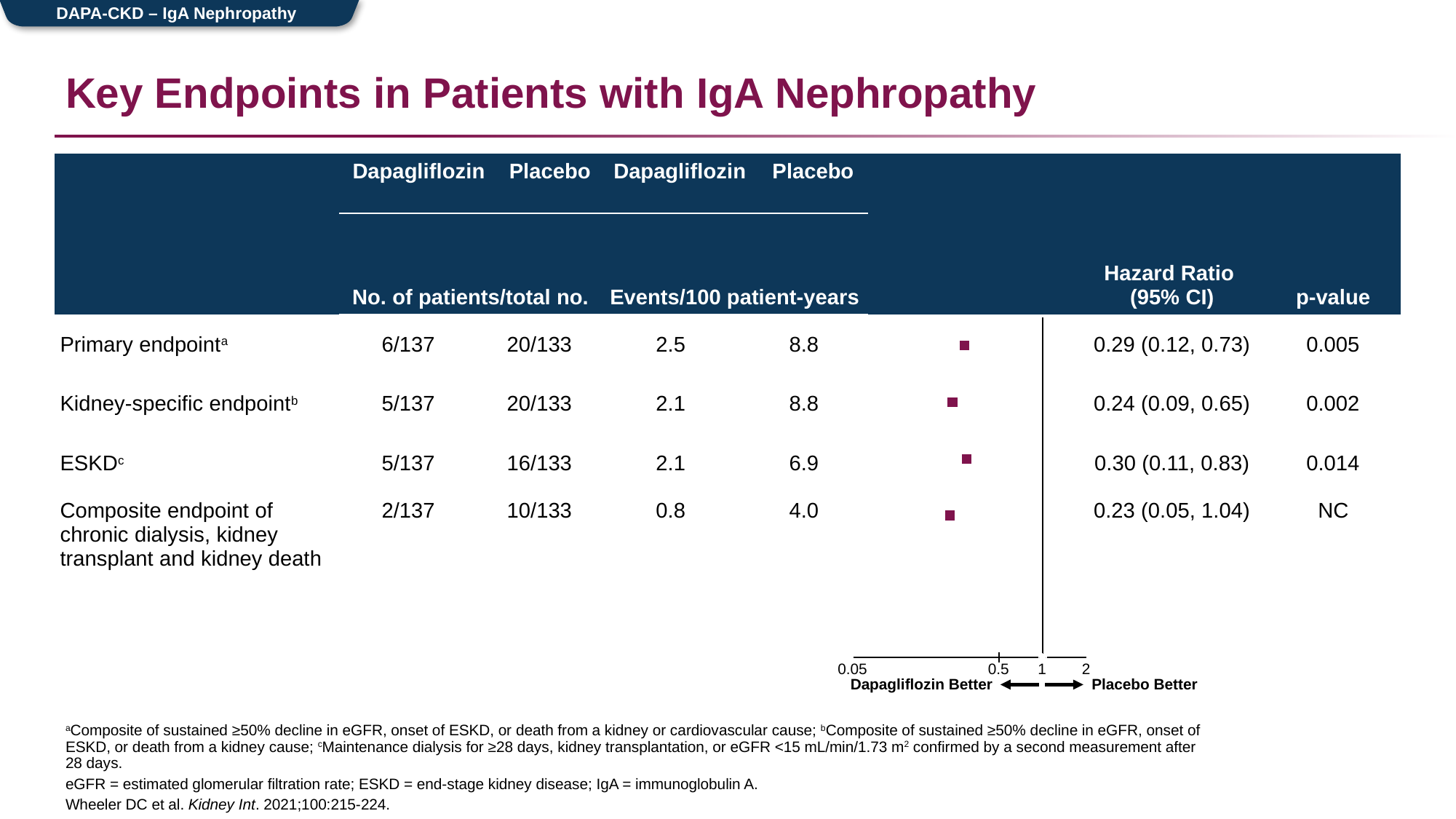
How many endpoints are plotted in the forest plot? 4 What is the p-value for the kidney-specific endpoint? 0.002 What is the hazard ratio (95% CI) for ESKD? 0.30 (0.11, 0.83) What is the difference between the hazard ratio for ESKD and the hazard ratio for the kidney-specific endpoint? 0.06 Which endpoint has the highest hazard ratio? ESKD Is the hazard ratio for the primary endpoint greater or less than 0.5? less Which has the larger hazard ratio, ESKD or the kidney-specific endpoint? ESKD What kind of chart is shown on the slide? Forest plot Which endpoint has the lowest hazard ratio? Composite endpoint of chronic dialysis, kidney transplant and kidney death Is the hazard ratio for ESKD greater or less than 1? less What is the hazard ratio (95% CI) for the primary endpoint? 0.29 (0.12, 0.73) What does the label on the left side of the x axis arrow say? Dapagliflozin Better